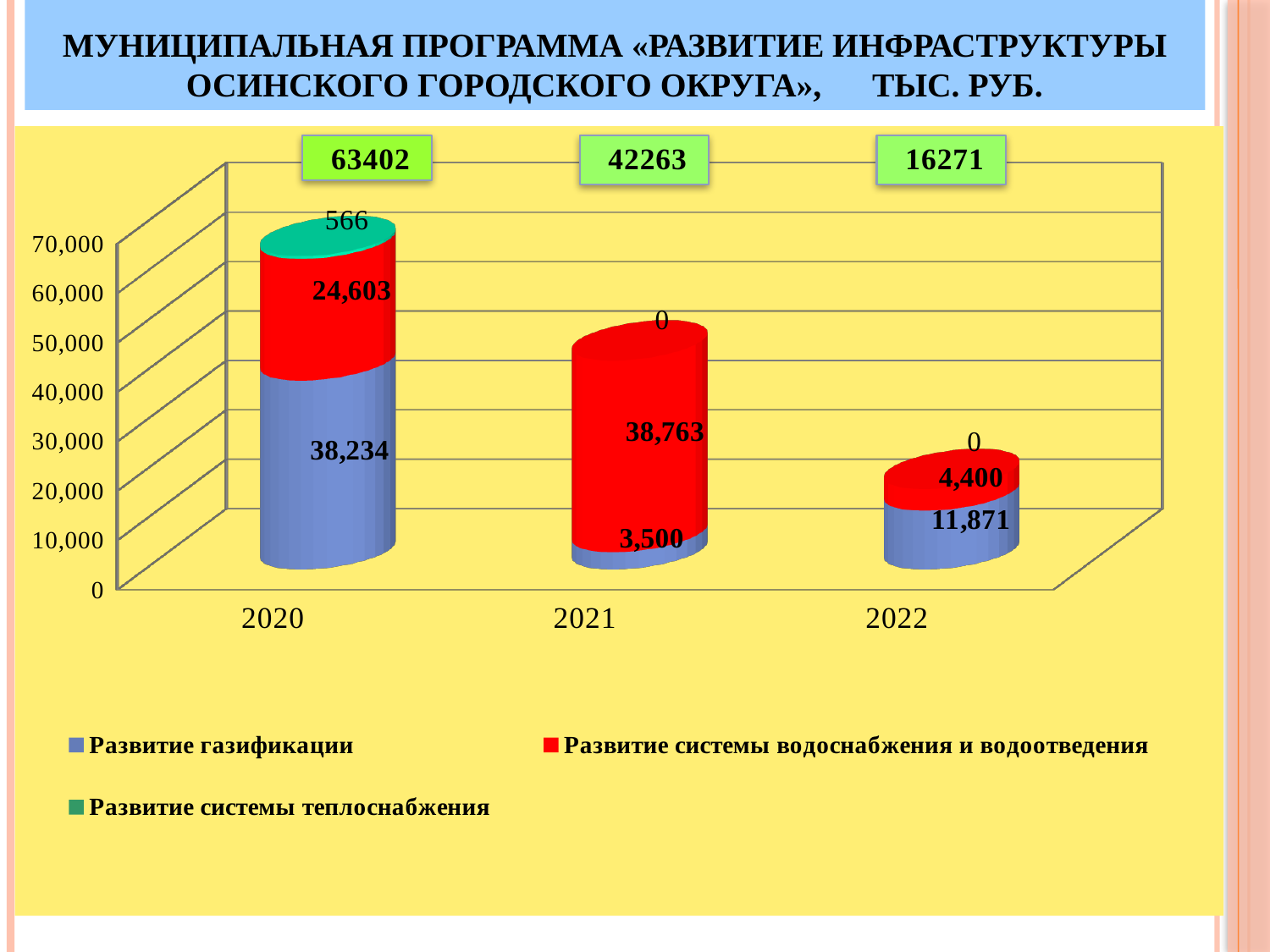
What is the difference between the Развитие газификации values for 2020 and 2021? 34,734 What is the total shown above the bar for 2021? 42263 Which is larger in 2022: Развитие газификации or Развитие системы водоснабжения и водоотведения? Развитие газификации What type of chart is shown on the slide? stacked bar chart What is the value for Развитие газификации in 2022? 11,871 Which year has the lowest total? 2022 What is the value for Развитие газификации in 2020? 38,234 How many years are shown on the x axis? 3 Which year has the highest total? 2020 What is the value for Развитие системы теплоснабжения in 2020? 566 How many series does the legend list? 3 What is the value for Развитие системы водоснабжения и водоотведения in 2021? 38,763